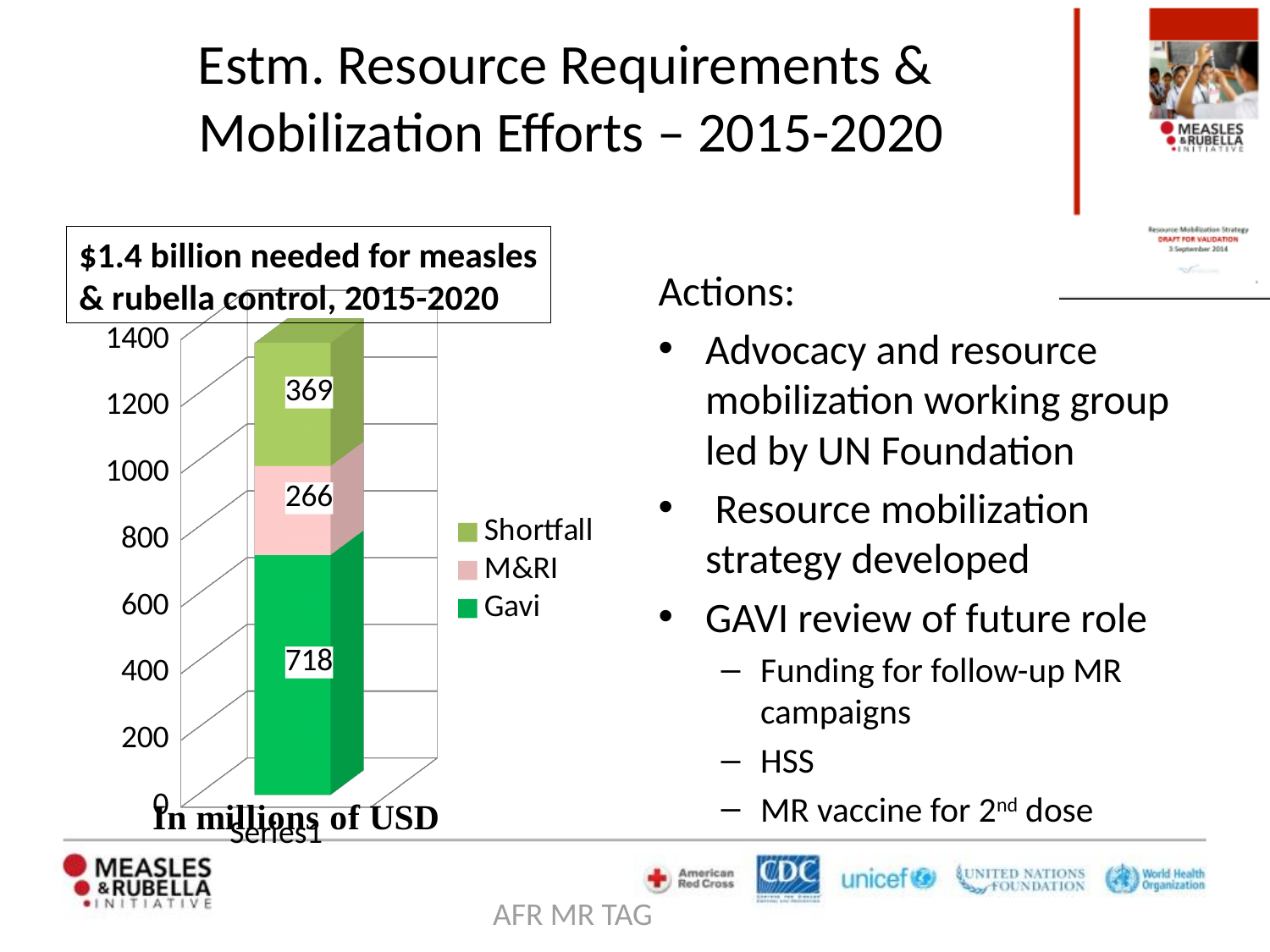
What is the value of the Gavi segment in the stacked bar? 718 What is the total of the stacked bar (Gavi + M&RI + Shortfall)? 1353 What unit is stated below the chart for the plotted values? In millions of USD How many series does the chart legend list? 3 What kind of chart is shown on the slide? Stacked bar chart Which series has the smallest value in the stacked bar? M&RI What is the difference between the Shortfall value and the M&RI value? 103 What is the value of the Shortfall segment in the stacked bar? 369 Which is larger, the Shortfall segment or the M&RI segment? Shortfall Which series has the largest value in the stacked bar? Gavi What is the difference between the Gavi value and the Shortfall value? 349 What is the value of the M&RI segment in the stacked bar? 266